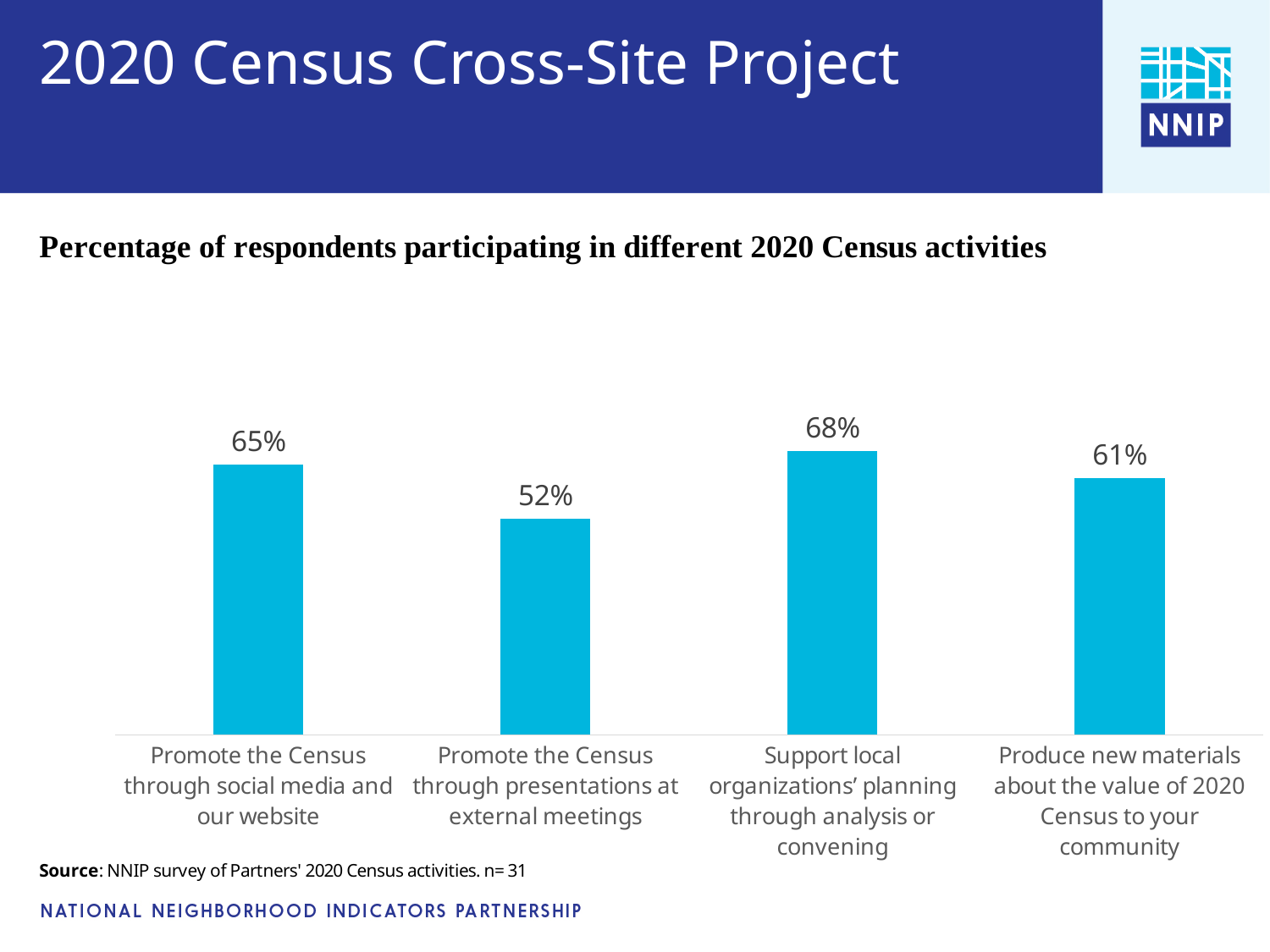
Which activity had the lowest percentage of respondents participating? Promote the Census through presentations at external meetings What is the difference in percentage points between supporting local organizations' planning and promoting the Census through presentations at external meetings? 16 What is the difference in percentage points between promoting the Census through social media and producing new materials about the value of the 2020 Census? 4 How many activities are shown in the chart? 4 What percentage of respondents promoted the Census through social media and their website? 65% What percentage of respondents promoted the Census through presentations at external meetings? 52% What percentage of respondents produced new materials about the value of 2020 Census to their community? 61% What type of chart is shown on the slide? Bar chart Which had a higher percentage of respondents: promoting the Census through social media and the website, or producing new materials about the value of 2020 Census? Promote the Census through social media and our website What percentage of respondents supported local organizations' planning through analysis or convening? 68% Which activity had the highest percentage of respondents participating? Support local organizations' planning through analysis or convening What is the title of the chart? Percentage of respondents participating in different 2020 Census activities